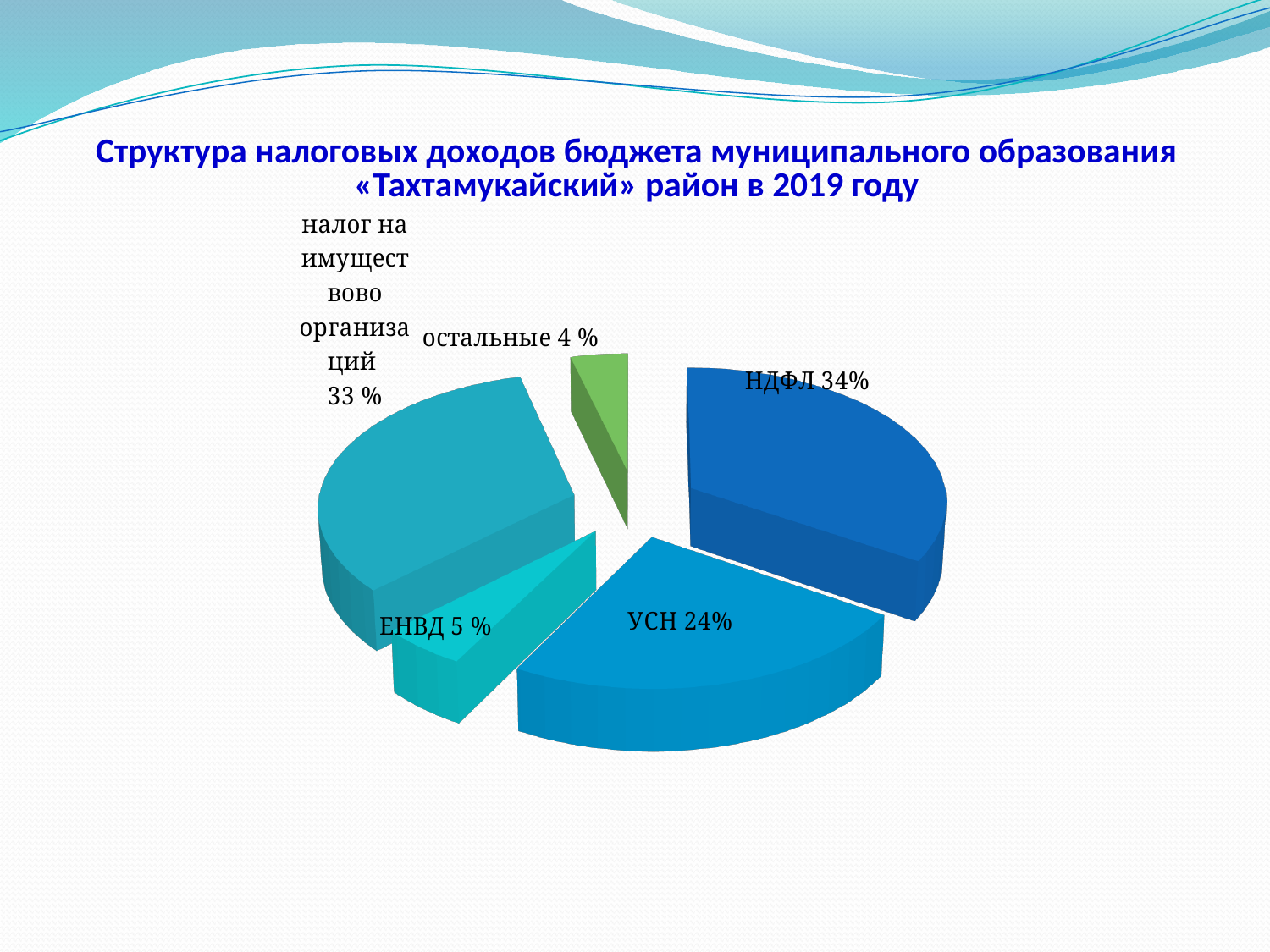
What share of the pie does остальные have? 4 % How many slices does the pie chart have? 5 Which category has the smallest share of the pie? остальные What year does the chart title refer to? 2019 What share of the pie does УСН have? 24% What share of the pie does НДФЛ have? 34% Which is larger, the share for УСН or the share for ЕНВД? УСН What is the difference in percentage points between НДФЛ and УСН? 10 What kind of chart is shown on the slide? pie chart What share of the pie does ЕНВД have? 5 % Which category has the largest share of the pie? НДФЛ What share of the pie does налог на имущество организаций have? 33 %